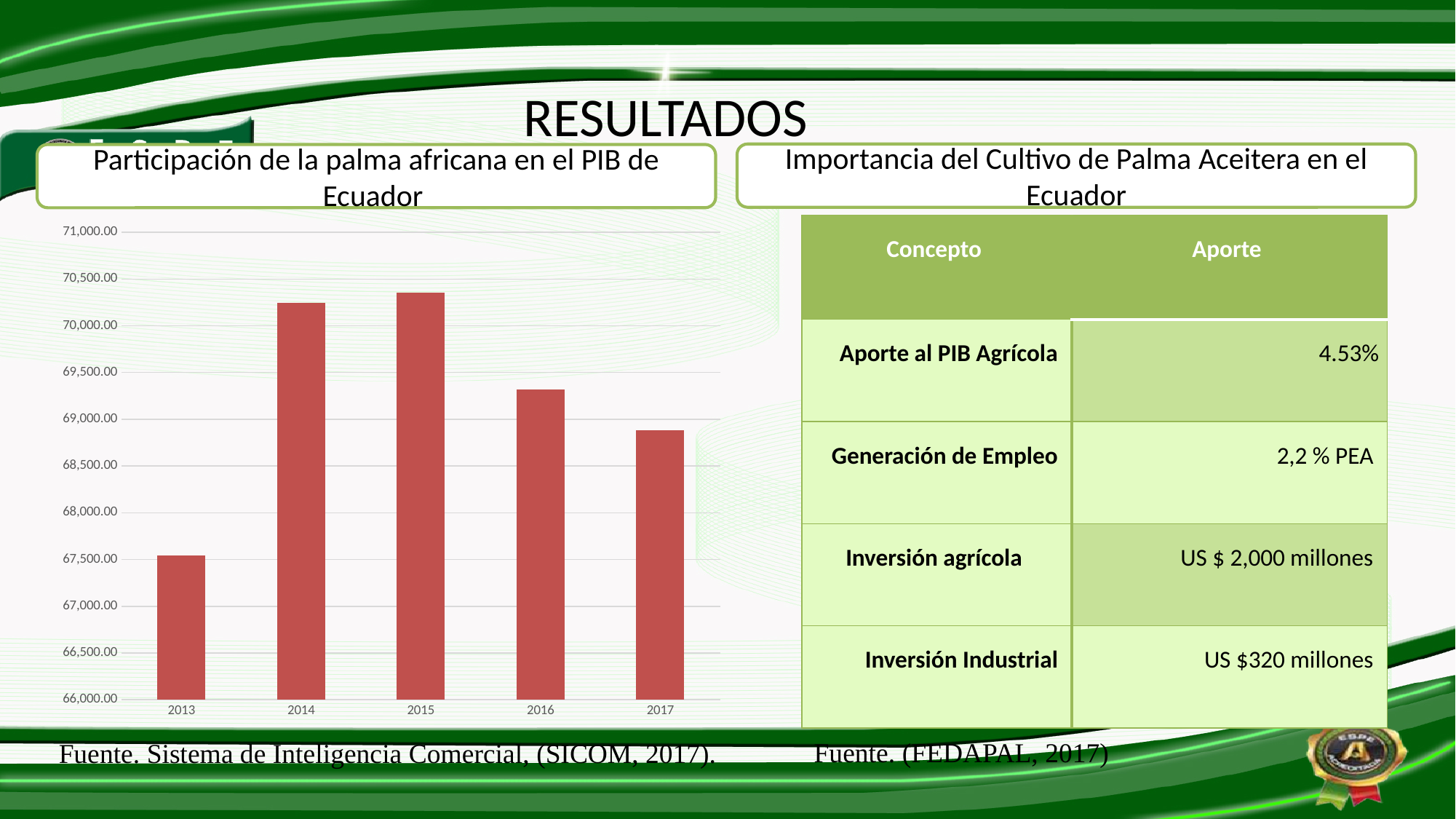
How many years are plotted in the bar chart? 5 Which year has the lowest bar in the chart? 2013 Which is larger in the bar chart, the value for 2014 or the value for 2016? 2014 Do the values in the bar chart rise or fall from 2015 to 2017? fall Is the value for 2017 greater or less than 69,500.00? less What is the first year shown on the x axis of the bar chart? 2013 What kind of chart is shown under the title 'Participación de la palma africana en el PIB de Ecuador'? bar chart Is the value for 2014 greater or less than 70,000.00? greater Is the value for 2016 greater or less than 69,000.00? greater Which is larger in the bar chart, the value for 2013 or the value for 2017? 2017